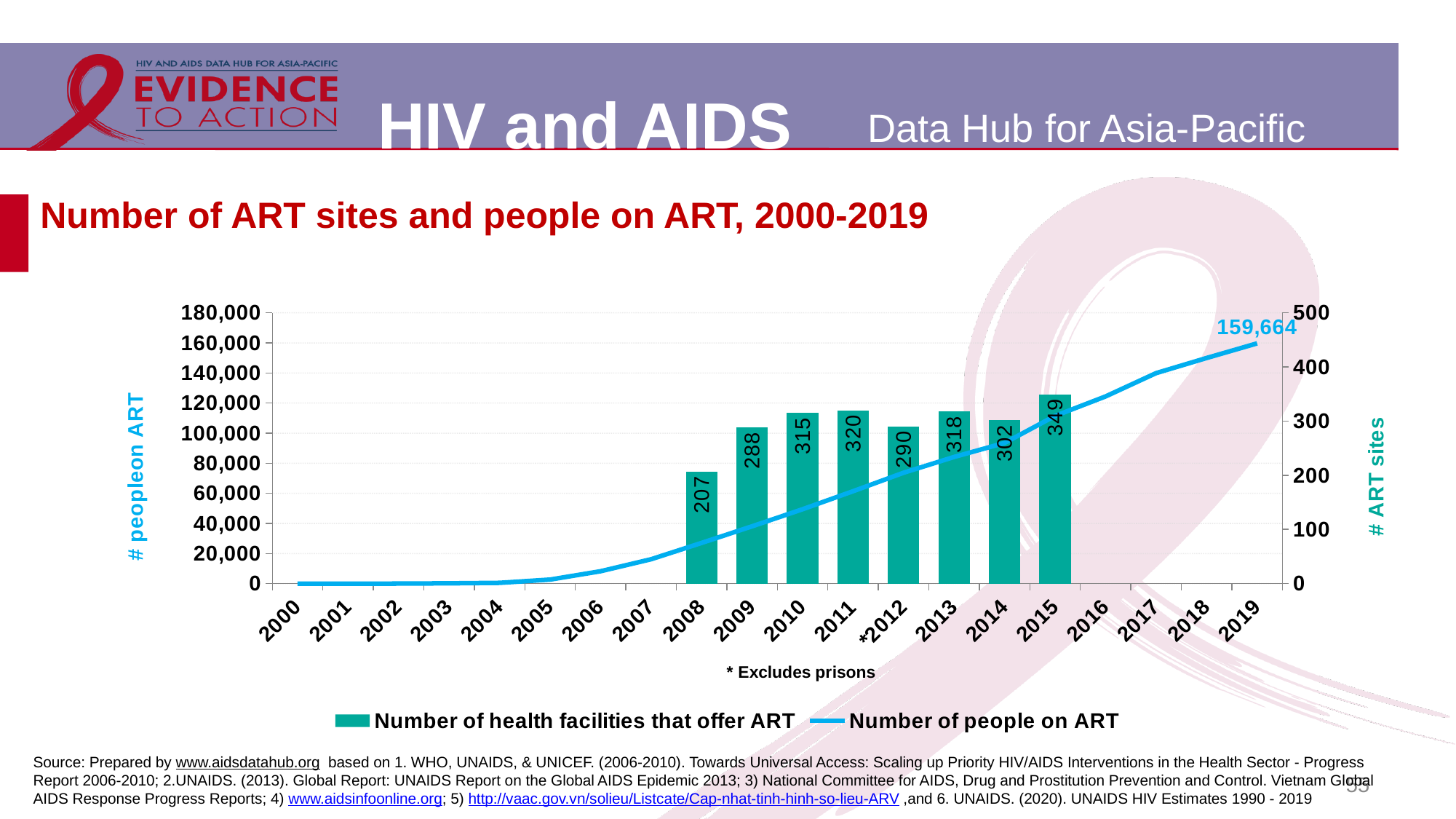
Which year has the highest number of health facilities that offer ART? 2015 What is the difference between the number of health facilities that offer ART in 2015 and in 2008? 142 What is the number of health facilities that offer ART in 2008? 207 How many series does the legend list? 2 What is the number of people on ART in 2019? 159,664 Does the number of people on ART rise or fall from 2000 to 2019? rise How many years have a bar for the number of health facilities that offer ART? 8 Which year has the lowest number of health facilities that offer ART? 2008 Is the number of people on ART in 2008 greater or less than 40,000? less What is the number of health facilities that offer ART in 2015? 349 Is the number of people on ART in 2017 greater or less than 120,000? greater Which year has more health facilities that offer ART, 2013 or 2014? 2013